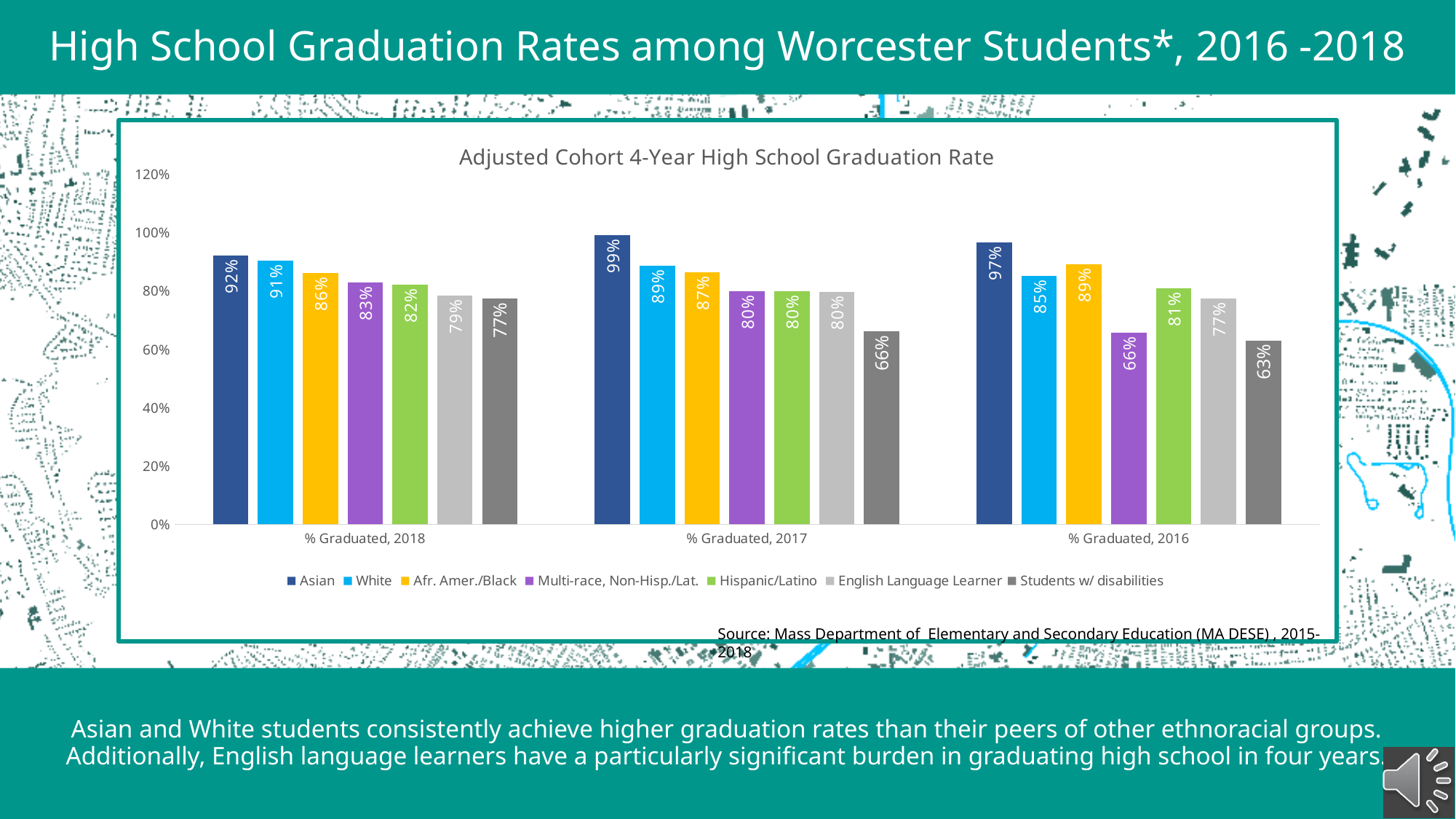
Which is larger in % Graduated, 2016: the rate for Afr. Amer./Black or the rate for White? Afr. Amer./Black How many series does the legend list? 7 Which group has the lowest graduation rate in % Graduated, 2017? Students w/ disabilities What is the graduation rate for English Language Learner in % Graduated, 2018? 79% Which group has the highest graduation rate in % Graduated, 2018? Asian What kind of chart is shown on the slide? Bar chart What is the difference between the Asian and White graduation rates in % Graduated, 2016? 12% What is the title of the chart? Adjusted Cohort 4-Year High School Graduation Rate What colour are the bars for Hispanic/Latino? Green What is the graduation rate for Students w/ disabilities in % Graduated, 2016? 63% How many year categories are shown on the x axis? 3 What is the graduation rate for Asian students in % Graduated, 2017? 99%